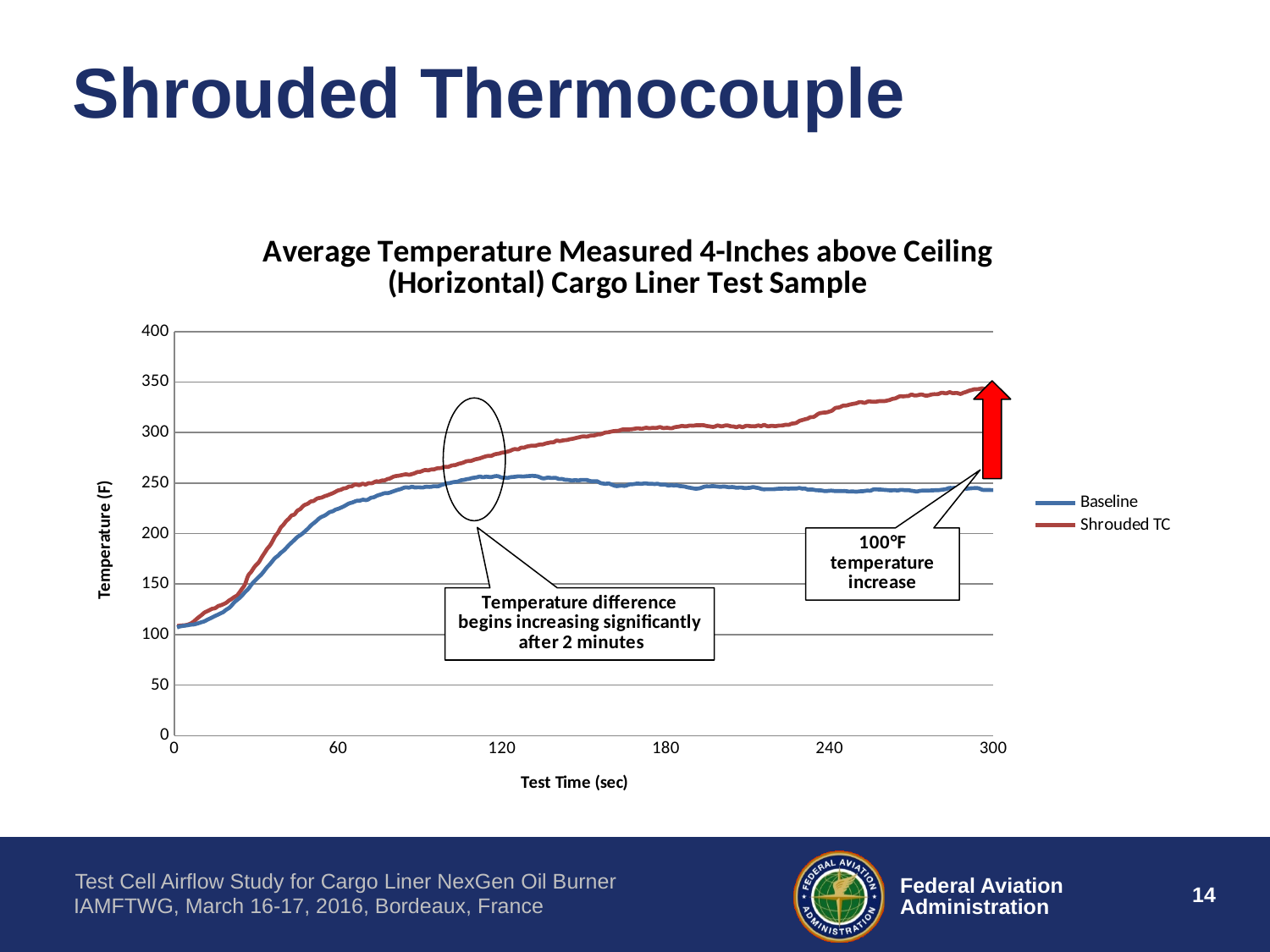
At 240 seconds, which series has the higher temperature, Baseline or Shrouded TC? Shrouded TC Is the Baseline value at 300 seconds greater or less than 300? less Is the Shrouded TC value at 300 seconds greater or less than 300? greater Is the Shrouded TC value at 180 seconds greater or less than 250? greater What is the label of the y axis? Temperature (F) What kind of chart is shown on the slide? line chart Does the Shrouded TC series generally rise or fall as test time increases? rise What are the two series named in the legend? Baseline and Shrouded TC How many series does the legend list? 2 At 300 seconds, which series has the higher temperature, Baseline or Shrouded TC? Shrouded TC